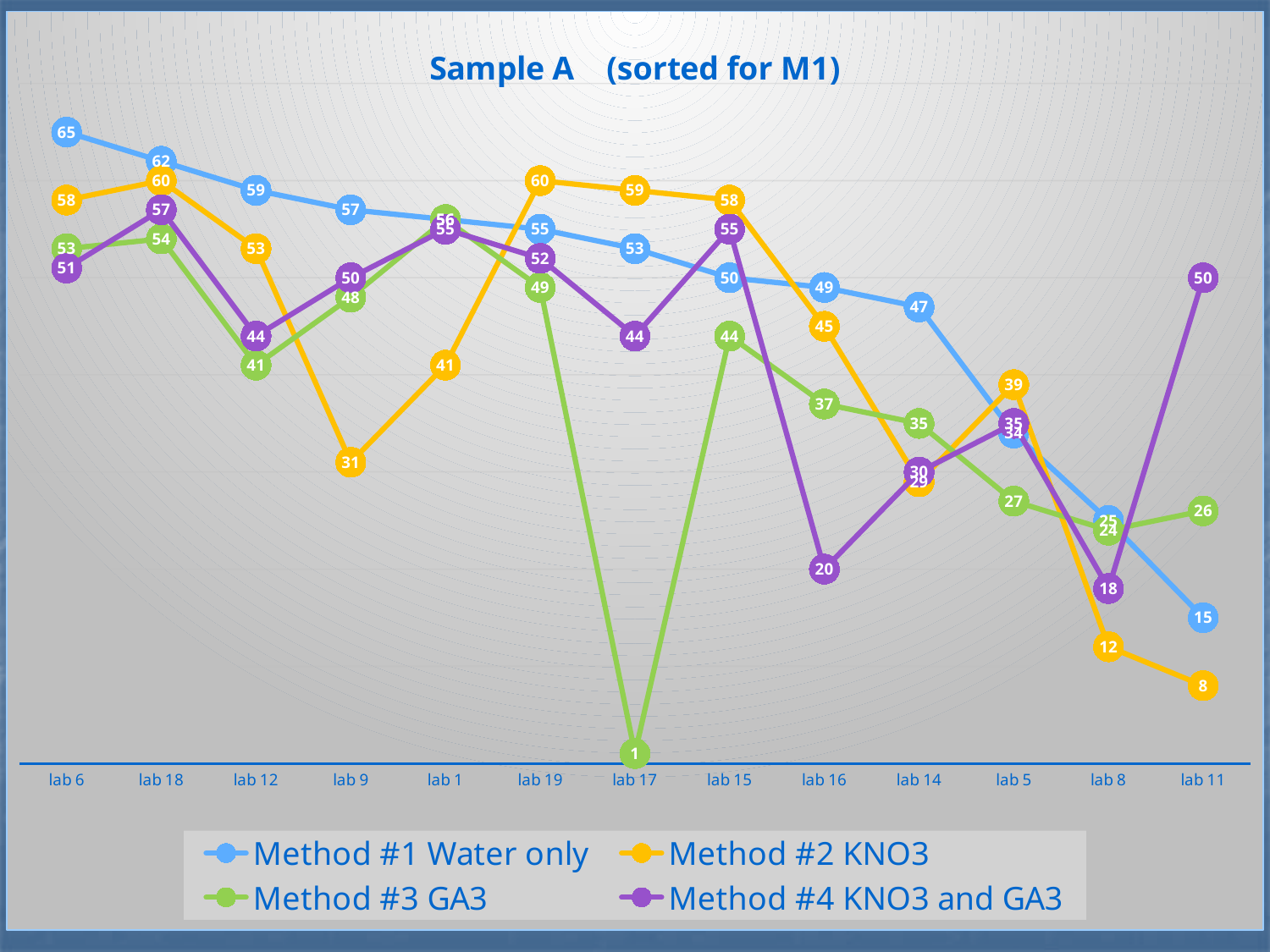
At lab 9, what is the difference between the Method #4 KNO3 and GA3 value and the Method #2 KNO3 value? 19 What is the value for Method #4 KNO3 and GA3 at lab 11? 50 What is the value for Method #2 KNO3 at lab 11? 8 How many series does the legend list? 4 What is the value for Method #3 GA3 at lab 17? 1 What kind of chart is shown on the slide? line chart What is the value for Method #1 Water only at lab 6? 65 Does the Method #1 Water only line rise or fall from left to right along the x axis? fall At lab 16, which is larger: Method #2 KNO3 or Method #4 KNO3 and GA3? Method #2 KNO3 At which lab does Method #1 Water only have its highest value? lab 6 How many labs are shown along the x axis? 13 At which lab does Method #3 GA3 have its lowest value? lab 17